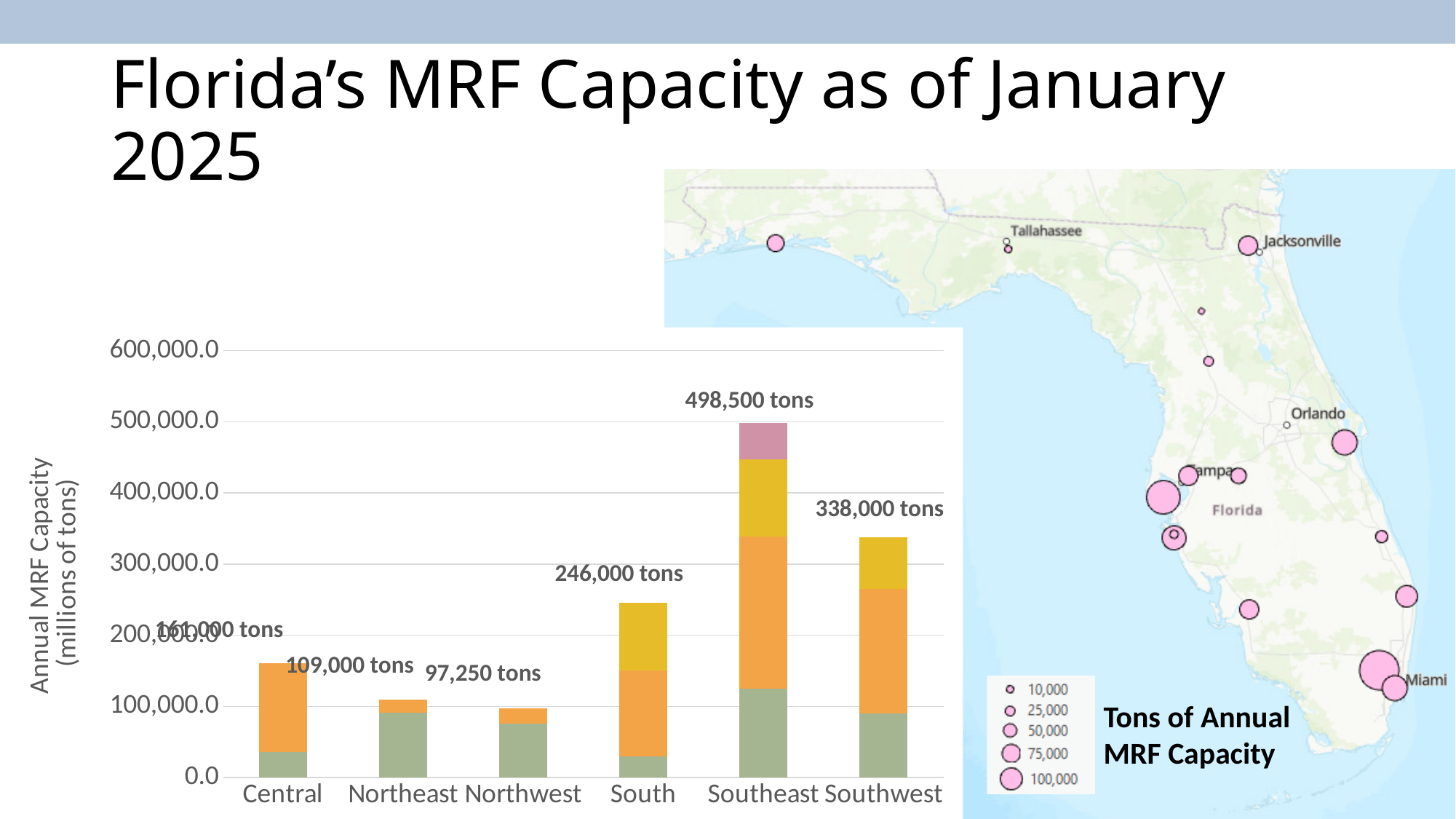
Which region has the highest total annual MRF capacity in the bar chart? Southeast Is the total capacity for the Central region greater or less than 100,000? greater What type of chart is used to show the regional MRF capacity? Stacked bar chart Which region has the larger total capacity, South or Southwest? Southwest What is the total annual MRF capacity shown for the Southeast region? 498,500 tons Which region has the lowest total annual MRF capacity in the bar chart? Northwest What is the difference between the South and Northeast total capacities? 137,000 tons What is the total annual MRF capacity shown for the South region? 246,000 tons What is the total annual MRF capacity shown for the Southwest region? 338,000 tons What is the total annual MRF capacity shown for the Northwest region? 97,250 tons How many regions are shown on the x axis of the bar chart? 6 What is the difference between the Southeast and Southwest total capacities? 160,500 tons